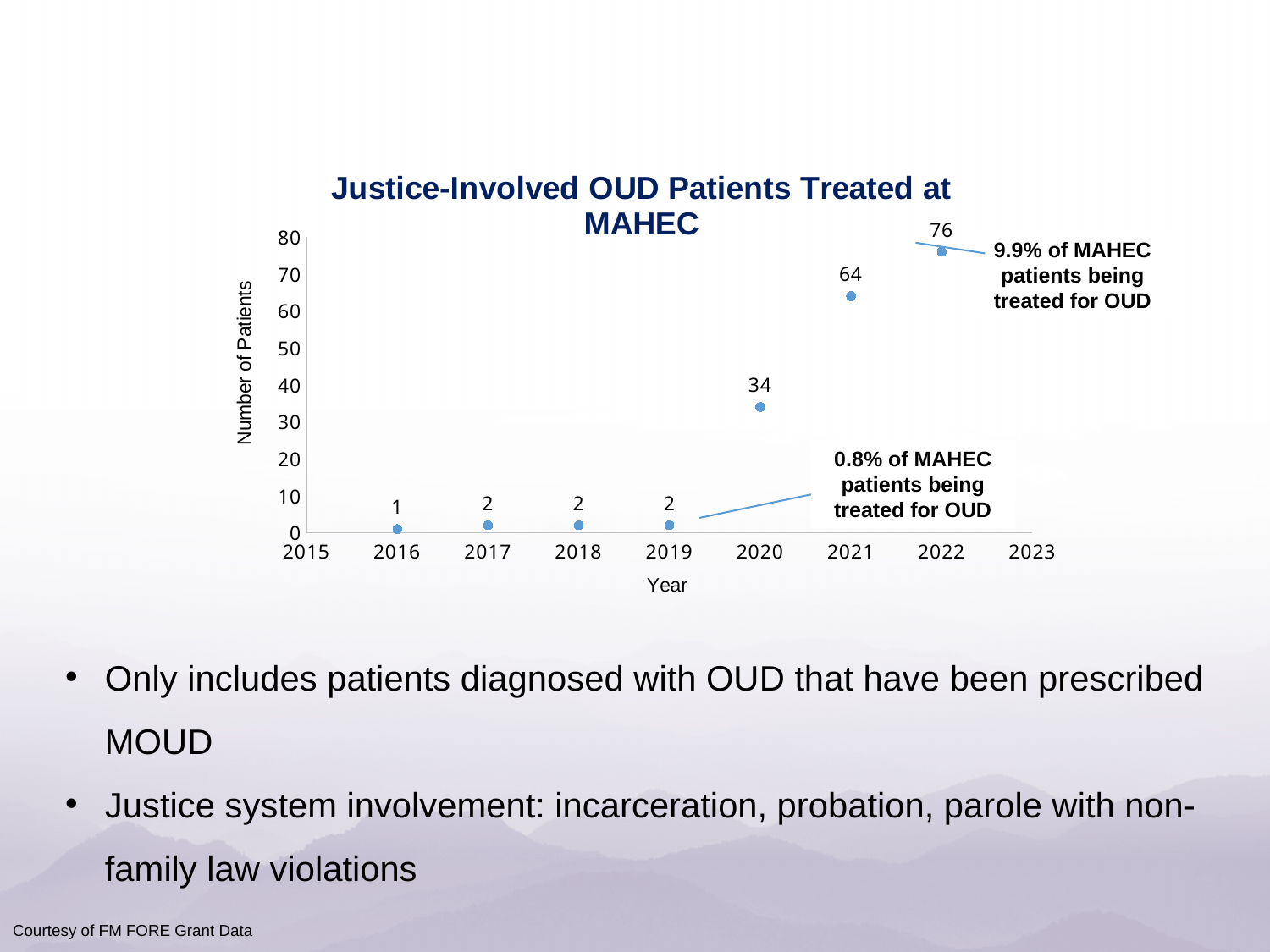
What is the number of patients shown for 2016? 1 Which year has more patients, 2020 or 2021? 2021 Which year has the highest number of patients? 2022 What is the number of justice-involved OUD patients treated at MAHEC in 2020? 34 Which year has the lowest number of patients? 2016 What is the number of patients shown for 2022? 76 Do the number of patients rise or fall from 2019 to 2022? Rise What is the title of the chart? Justice-Involved OUD Patients Treated at MAHEC What is the difference in number of patients between 2021 and 2020? 30 What is the difference in number of patients between 2022 and 2021? 12 What type of chart is shown on the slide? Scatter chart How many data points are plotted in the chart? 7